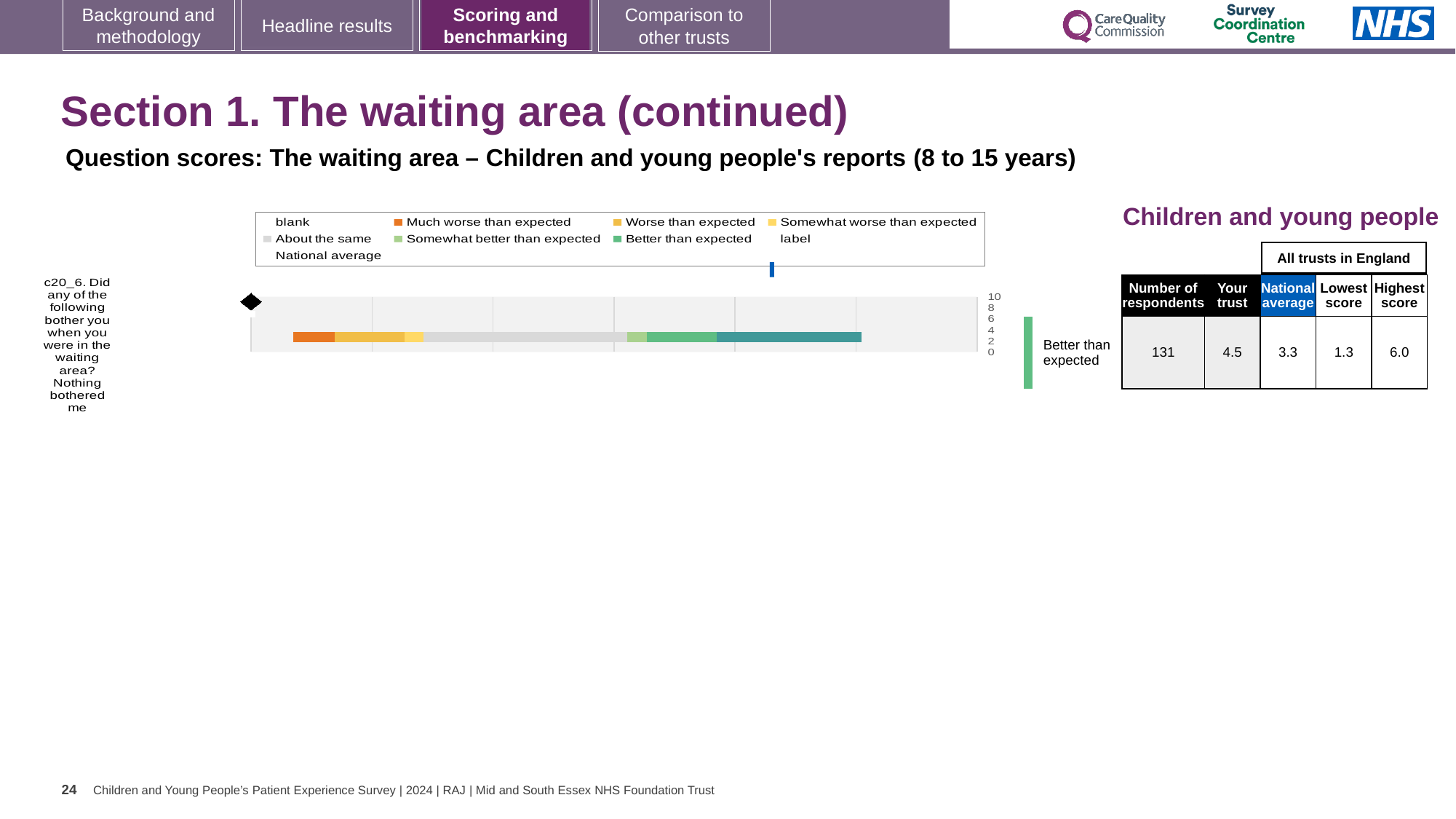
What is the question code of the category plotted in the chart? c20_6 What benchmark category label is shown to the right of the bar for question c20_6? Better than expected What kind of chart is shown on the slide? bar chart How many question categories are plotted in the chart? 1 What is the number of respondents for question c20_6? 131 What is the lowest score across all trusts in England for question c20_6? 1.3 What is the 'Your trust' score for question c20_6 in the Children and young people table? 4.5 What colour does the legend use for 'Much worse than expected'? orange What is the highest score across all trusts in England for question c20_6? 6.0 What is the national average score for question c20_6 in the Children and young people table? 3.3 Which is larger for question c20_6, the 'Your trust' score or the national average? Your trust What is the difference between the 'Your trust' score and the national average for question c20_6? 1.2